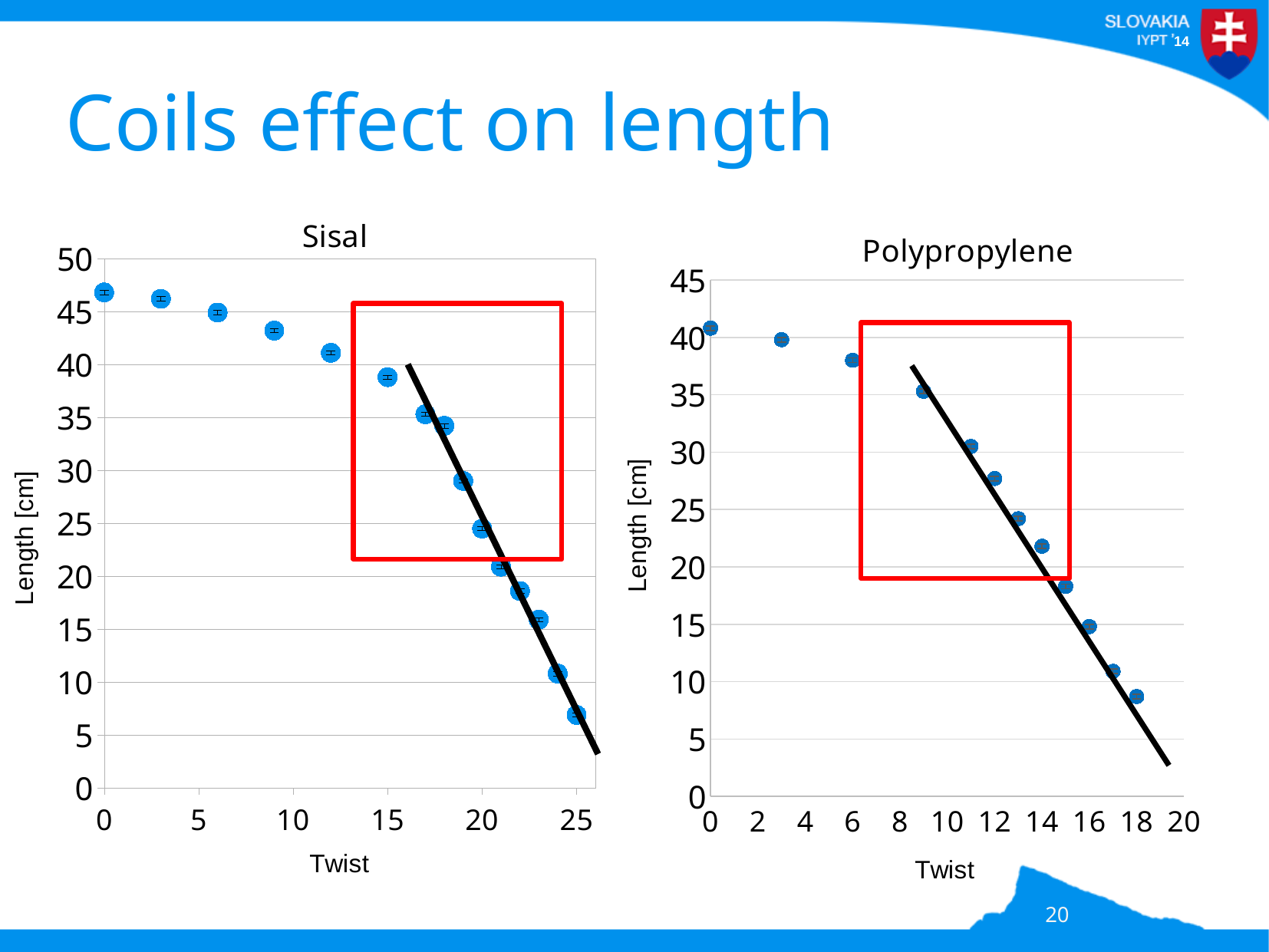
In the Polypropylene chart, is the length at twist 9 greater or less than 30? greater What is the y-axis label of the Polypropylene chart? Length [cm] In the Sisal chart, is the length at twist 0 greater or less than 45? greater In the Polypropylene chart, does the length rise or fall as twist increases? fall In the Sisal chart, at which twist value is the length highest? 0 What type of chart is the Sisal chart? scatter chart In the Sisal chart, is the length at twist 20 greater or less than 30? less In the Sisal chart, does the length rise or fall as twist increases? fall In the Sisal chart, which is larger: the length at twist 0 or at twist 25? twist 0 In the Polypropylene chart, at which twist value is the length lowest? 18